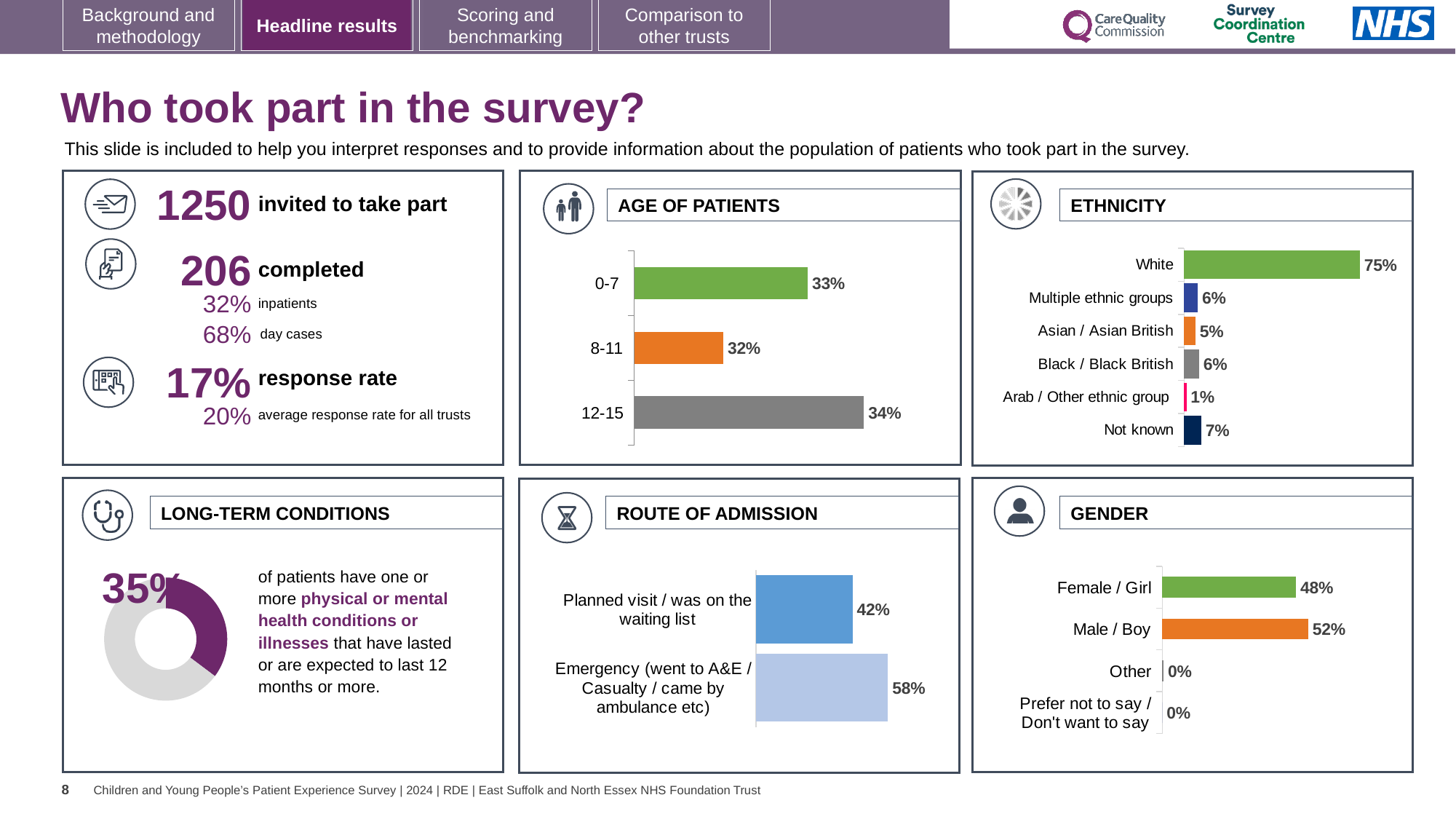
In the ETHNICITY chart, which ethnic group has the lowest percentage? Arab / Other ethnic group In the AGE OF PATIENTS chart, which age group has the highest percentage? 12-15 In the GENDER chart, what percentage of patients were Male / Boy? 52% In the ETHNICITY chart, what is the difference between the percentage for White and the percentage for Not known? 68% In the ETHNICITY chart, what percentage of patients were White? 75% What type of chart is used in the LONG-TERM CONDITIONS panel? Donut chart In the ETHNICITY chart, how many ethnicity categories are shown? 6 In the LONG-TERM CONDITIONS panel, what percentage of patients have one or more physical or mental health conditions or illnesses? 35% In the ROUTE OF ADMISSION chart, what percentage of patients came via Emergency (went to A&E / Casualty / came by ambulance etc)? 58% In the GENDER chart, what is the difference between the Male / Boy and Female / Girl percentages? 4% In the ROUTE OF ADMISSION chart, which route has the larger percentage: Planned visit / was on the waiting list or Emergency? Emergency (went to A&E / Casualty / came by ambulance etc) In the AGE OF PATIENTS chart, what percentage of patients were aged 8-11? 32%